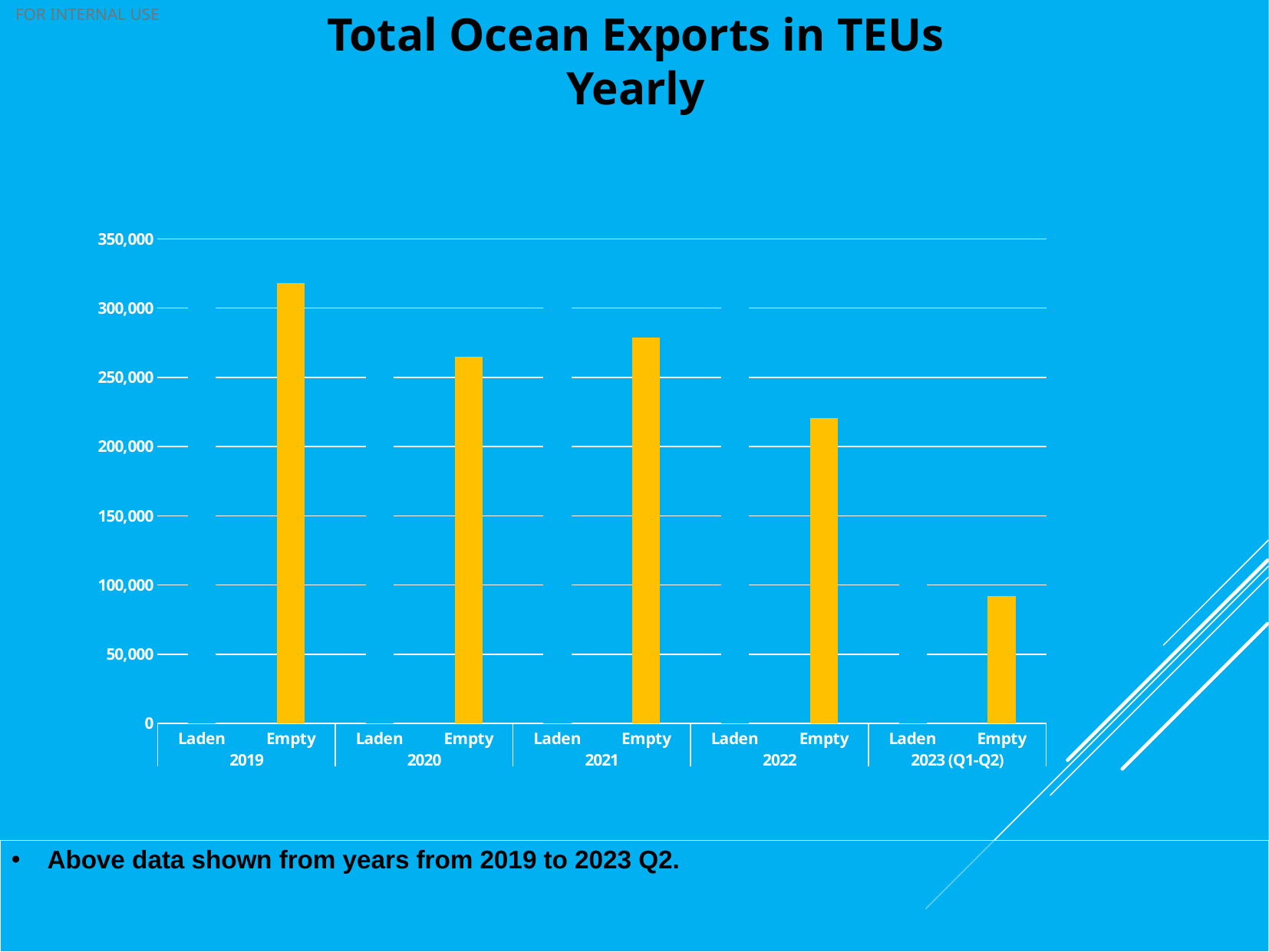
Which year has the lowest Empty bar? 2023 (Q1-Q2) What is the title of the chart? Total Ocean Exports in TEUs Yearly Is the Empty value for 2019 greater or less than 300,000? greater Overall, do the Empty values rise or fall from 2019 to 2023 (Q1-Q2)? fall Is the Empty value for 2020 greater or less than 250,000? greater Is the Empty value for 2023 (Q1-Q2) greater or less than 100,000? less What type of chart is shown on the slide? Bar chart How many year groups are shown along the x axis? 5 Which year has the highest Empty bar? 2019 Which is larger, the Empty value for 2020 or the Empty value for 2021? 2021